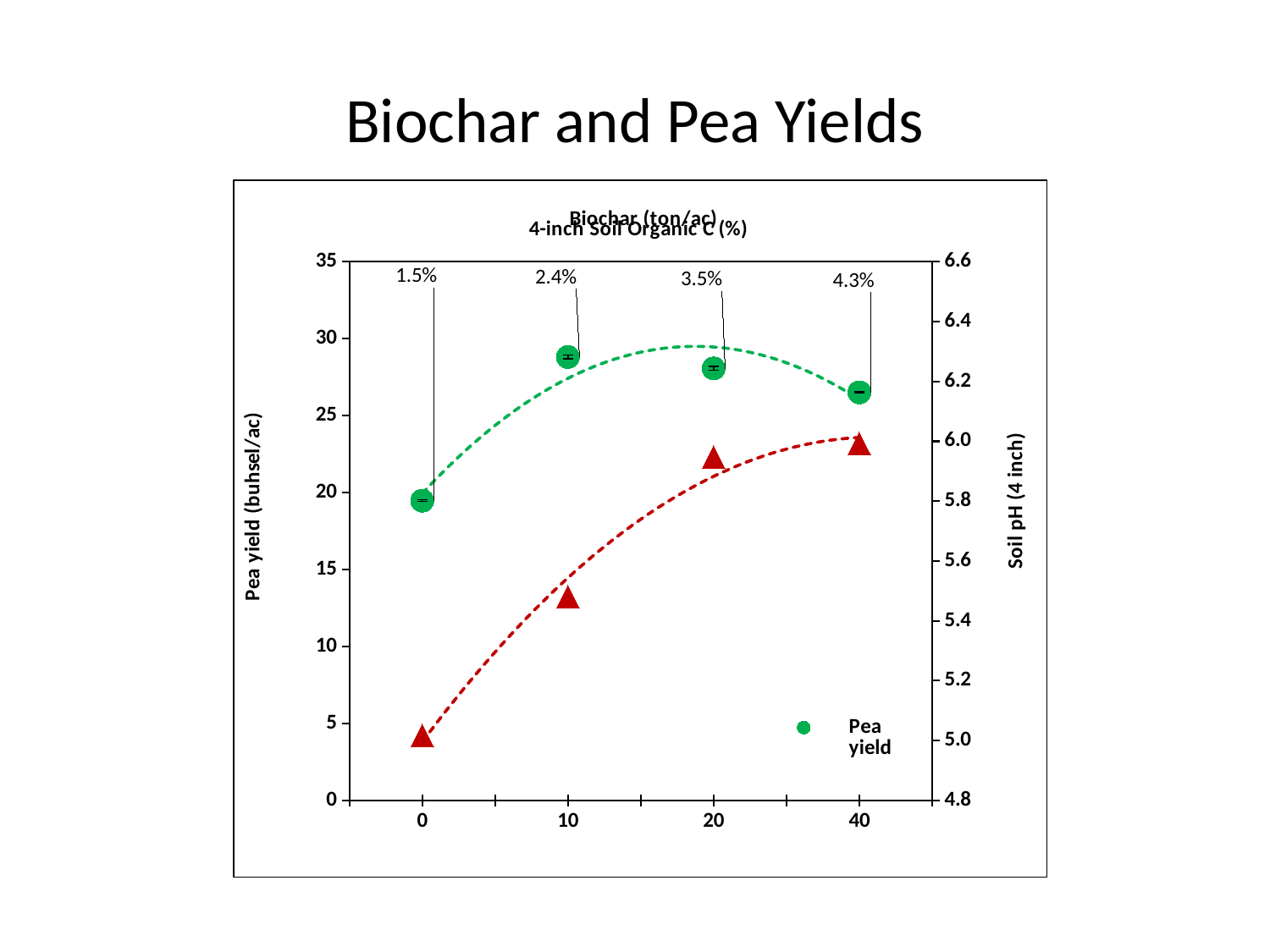
Which biochar rate has the lowest pea yield? 0 ton/ac Is the soil pH at 0 ton/ac biochar greater or less than 5.2? less Which has the higher pea yield, 0 ton/ac or 10 ton/ac biochar? 10 ton/ac Does soil pH rise or fall as the biochar rate increases from 0 to 40 ton/ac? rise What is the 4-inch soil organic C value labelled at the 40 ton/ac biochar rate? 4.3% How many biochar application rates are plotted on the x axis? 4 What kind of chart is shown on the slide? line chart Is the pea yield at 10 ton/ac biochar greater or less than 25 bushels/ac? greater What is the 4-inch soil organic C value labelled at the 20 ton/ac biochar rate? 3.5% What is the 4-inch soil organic C value labelled at the 0 ton/ac biochar rate? 1.5% What is the label on the right-hand y axis? Soil pH (4 inch) Which biochar rate has the lowest soil pH? 0 ton/ac